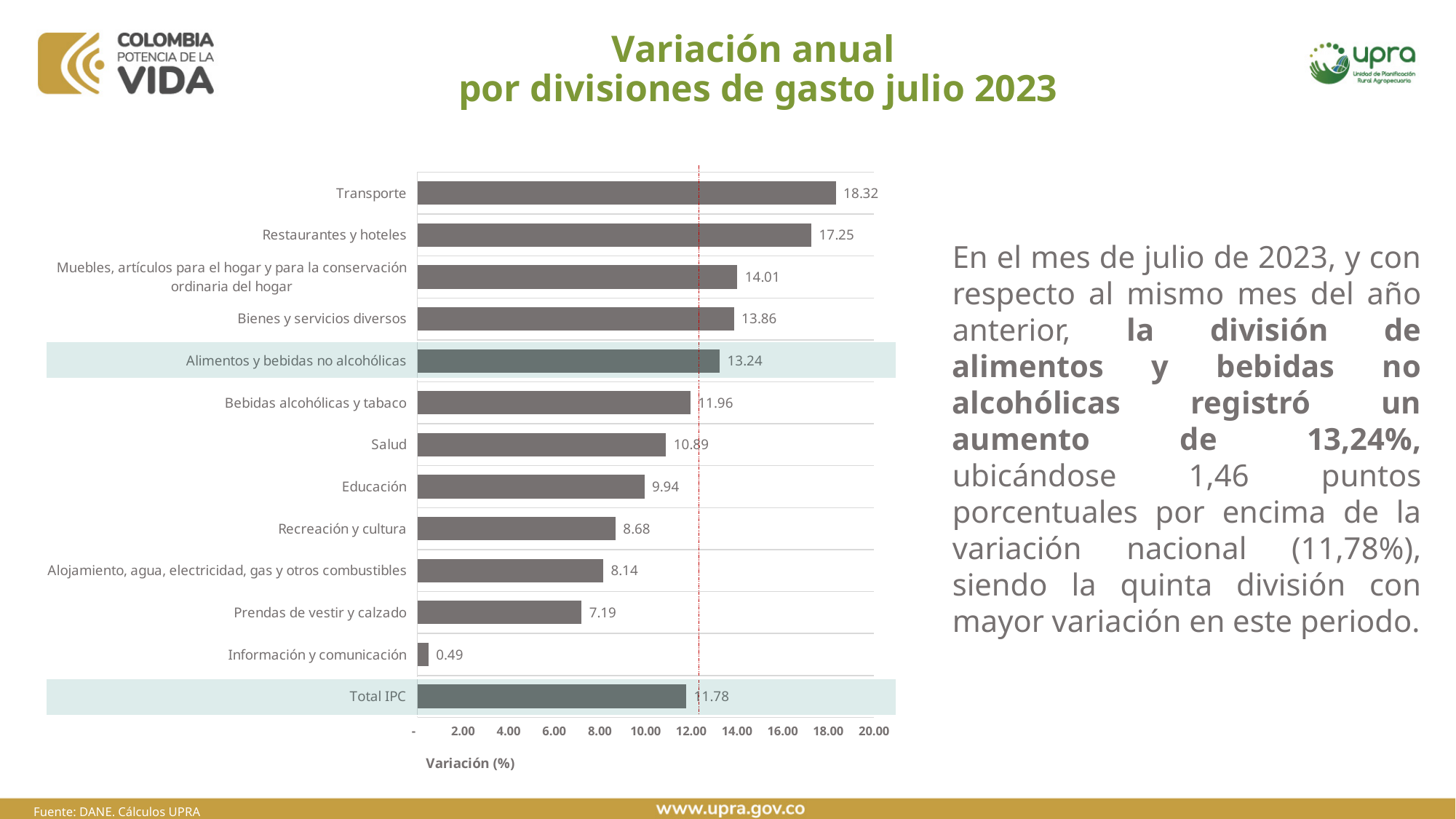
Is the value for Bienes y servicios diversos greater or less than 12.00? greater What is the value for Alimentos y bebidas no alcohólicas? 13.24 What kind of chart is shown on the slide? Bar chart What is the value for Información y comunicación? 0.49 What is the value for Transporte? 18.32 What is the value for Total IPC? 11.78 How many categories (bars) are shown in the chart? 13 Which is larger, the value for Salud or the value for Educación? Salud Which category has the lowest value? Información y comunicación Which category has the highest value? Transporte What is the difference between the values for Alimentos y bebidas no alcohólicas and Total IPC? 1.46 What is the difference between the values for Transporte and Restaurantes y hoteles? 1.07